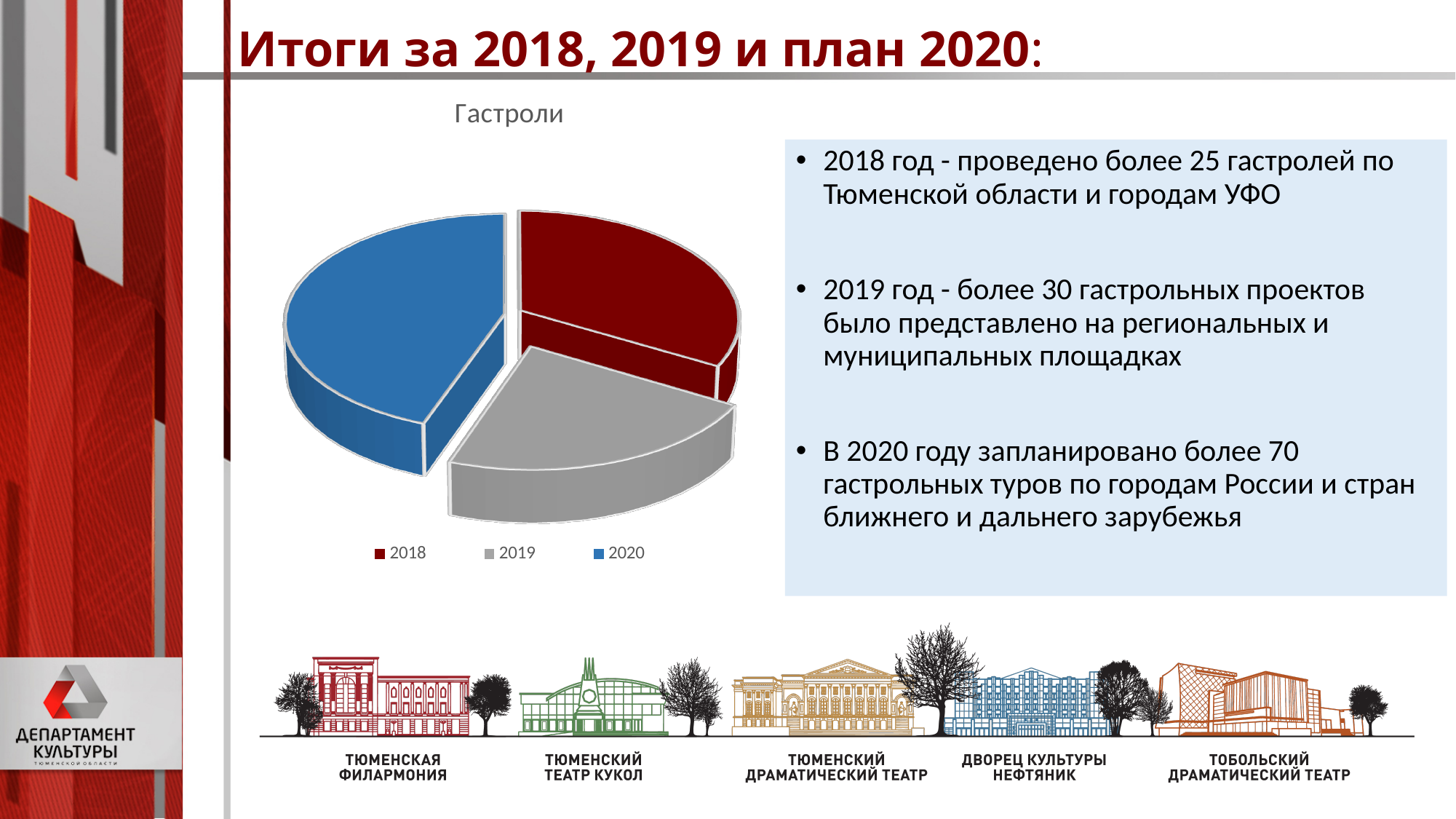
Which year has the largest slice in the pie chart? 2020 How many entries does the chart legend list? 3 How many slices does the pie chart have? 3 What is the title of the chart? Гастроли What kind of chart is shown on the slide? pie chart Which slice is larger, 2020 or 2019? 2020 Which slice is larger, 2020 or 2018? 2020 Which colour represents 2020 in the pie chart? blue